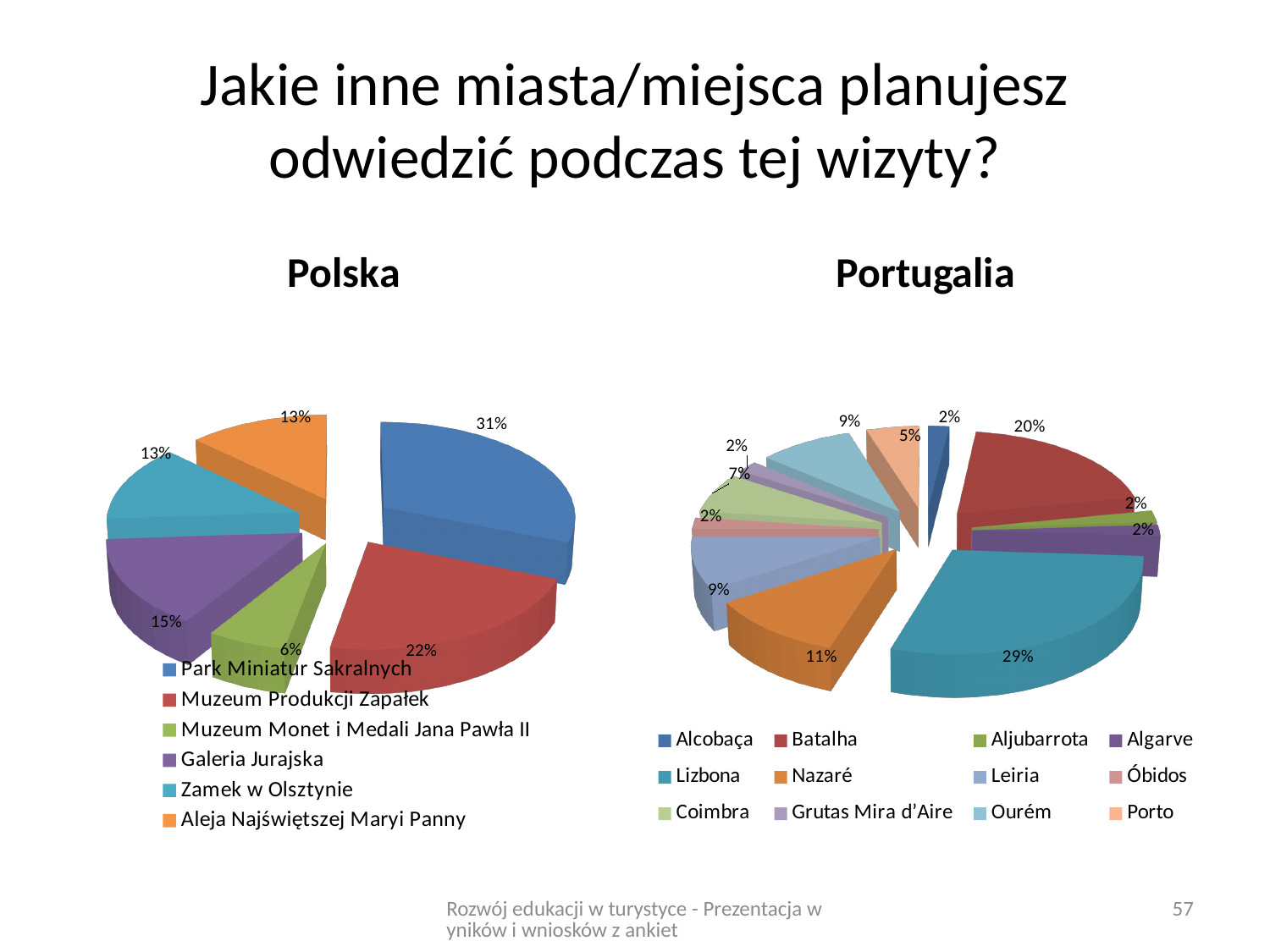
In the Polska chart, what is the value for Galeria Jurajska? 15% In the Polska chart, which category has the smallest share? Muzeum Monet i Medali Jana Pawła II In the Polska chart, what colour is the slice for Zamek w Olsztynie? Teal In the Portugalia chart, what is the value for Batalha? 20% In the Portugalia chart, which is larger, Coimbra or Porto? Coimbra In the Polska chart, what is the difference between Park Miniatur Sakralnych and Muzeum Produkcji Zapałek? 9% In the Polska chart, what share does Park Miniatur Sakralnych have? 31% In the Portugalia chart, which category has the largest share? Lizbona In the Polska chart, how many categories does the legend list? 6 In the Portugalia chart, what share does Nazaré have? 11% What kind of chart is the Polska chart? Pie chart In the Portugalia chart, how many categories does the legend list? 12